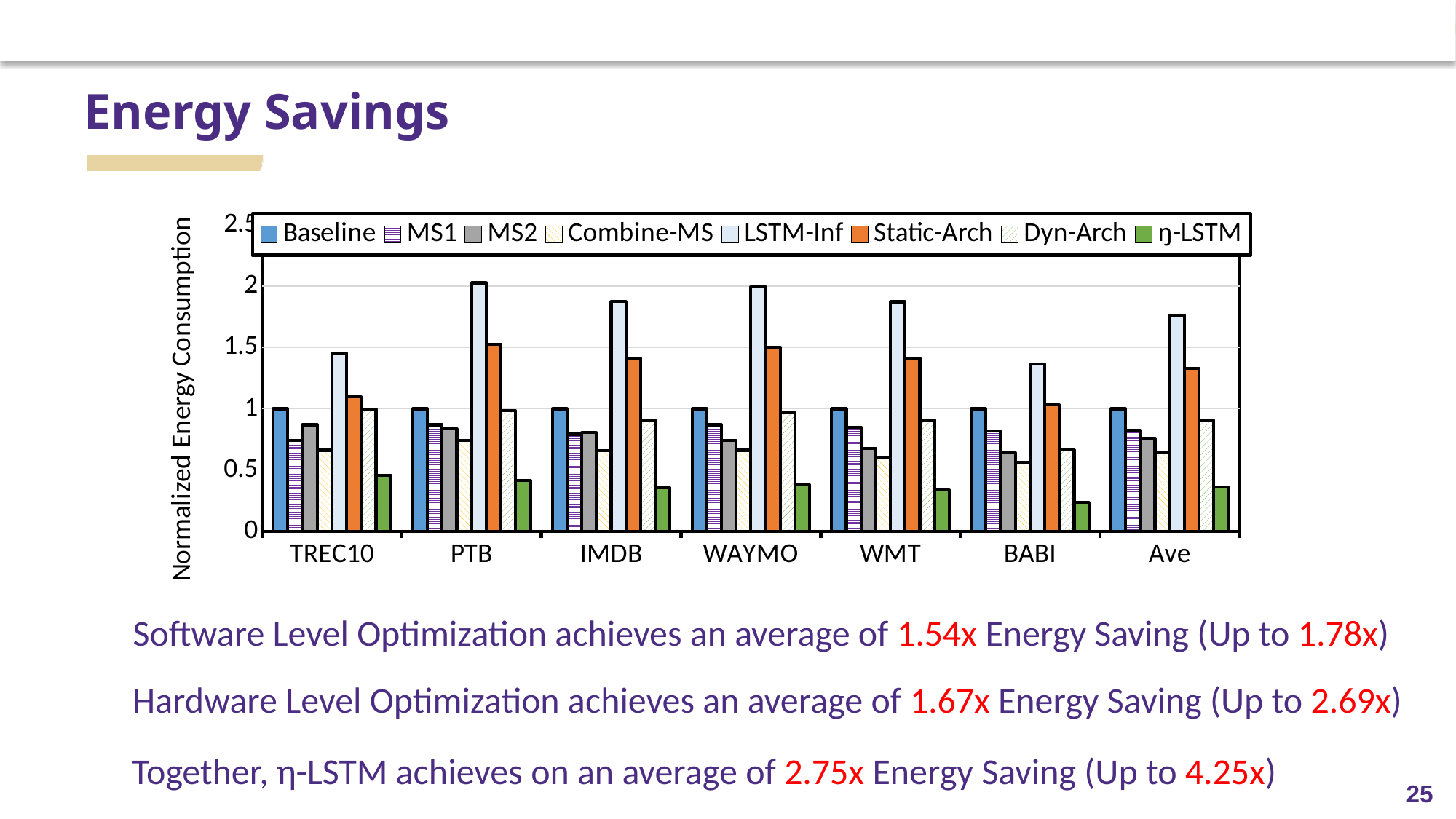
How many series does the chart's legend list? 8 Is the LSTM-Inf value for PTB greater or less than 1.5? greater How many categories are shown along the x axis of the chart? 7 Is the Static-Arch value for Ave greater or less than 1? greater What kind of chart is shown on the slide? bar chart Which series has the highest bar in the PTB group? LSTM-Inf Is the η-LSTM value for BABI greater or less than 0.5? less Which series has the lowest bar in the WAYMO group? η-LSTM Which category has the lowest η-LSTM bar? BABI What is the label of the y axis? Normalized Energy Consumption What is the Baseline value for TREC10? 1 Which is larger for TREC10, the MS1 bar or the MS2 bar? MS2